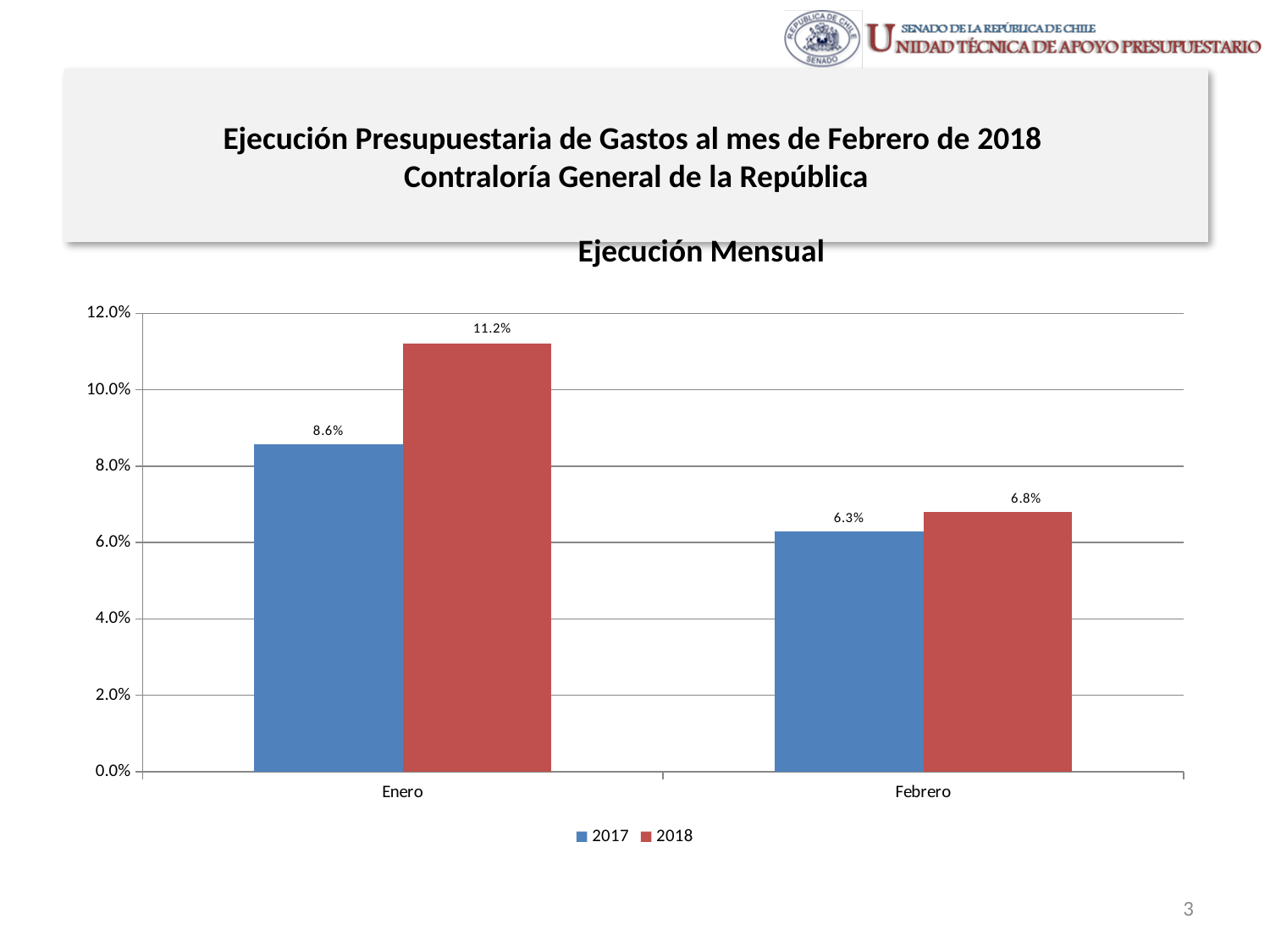
Is the value for 2018 in Enero greater or less than 10.0%? greater What is the value for 2018 in Enero? 11.2% Which month has the lowest value for 2017? Febrero What is the value for 2017 in Febrero? 6.3% Which month has the highest value for 2018? Enero How many months are shown on the x axis? 2 How many series does the legend list? 2 Which is larger in Febrero, the value for 2017 or for 2018? 2018 What is the difference between the 2018 and 2017 values in Enero? 2.6% What is the value for 2018 in Febrero? 6.8% What kind of chart is shown? bar chart What is the value for 2017 in Enero? 8.6%